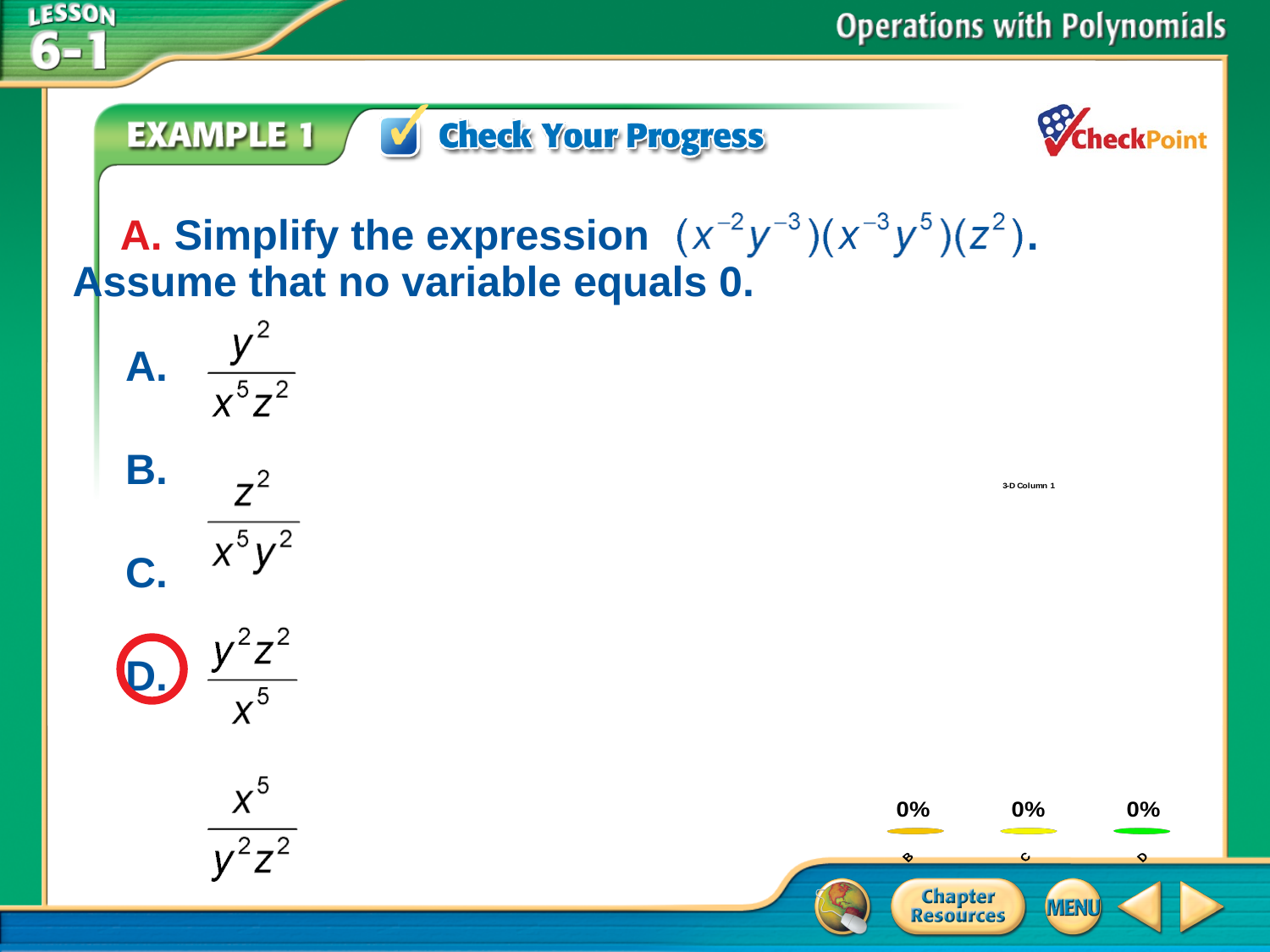
In the chart at the bottom right of the slide, are the values for B and C the same or different? the same In the chart at the bottom right of the slide, what value is shown for category B? 0% In the chart at the bottom right of the slide, what value is shown for category C? 0% What kind of chart is shown at the bottom right of the slide? bar chart In the chart at the bottom right of the slide, what value is shown for category D? 0%